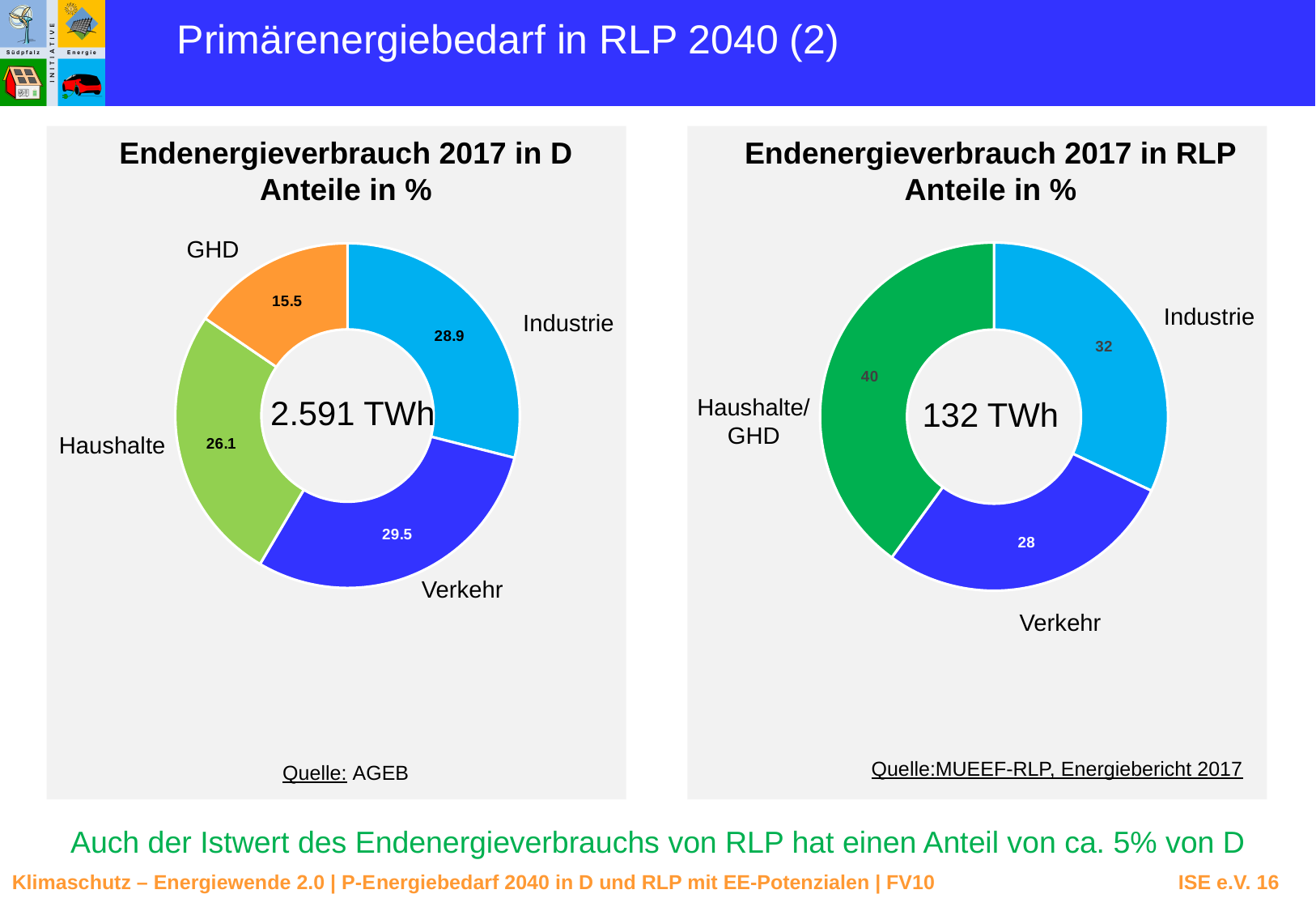
In the chart 'Endenergieverbrauch 2017 in RLP', which is larger, Industrie or Verkehr? Industrie In the chart 'Endenergieverbrauch 2017 in D', what is the value for GHD? 15.5 In the chart 'Endenergieverbrauch 2017 in D', which category has the smallest share? GHD In the chart 'Endenergieverbrauch 2017 in D', which category has the largest share? Verkehr In the chart 'Endenergieverbrauch 2017 in D', what is the difference between the values for Verkehr and Haushalte? 3.4 In the chart 'Endenergieverbrauch 2017 in RLP', what is the value for Verkehr? 28 What kind of chart is 'Endenergieverbrauch 2017 in RLP'? Doughnut chart What total is printed in the centre of the chart 'Endenergieverbrauch 2017 in RLP'? 132 TWh In the chart 'Endenergieverbrauch 2017 in D', what is the value for Industrie? 28.9 In the chart 'Endenergieverbrauch 2017 in RLP', what is the value for Haushalte/GHD? 40 In the chart 'Endenergieverbrauch 2017 in RLP', how many categories are shown? 3 In the chart 'Endenergieverbrauch 2017 in D', how many categories are shown? 4